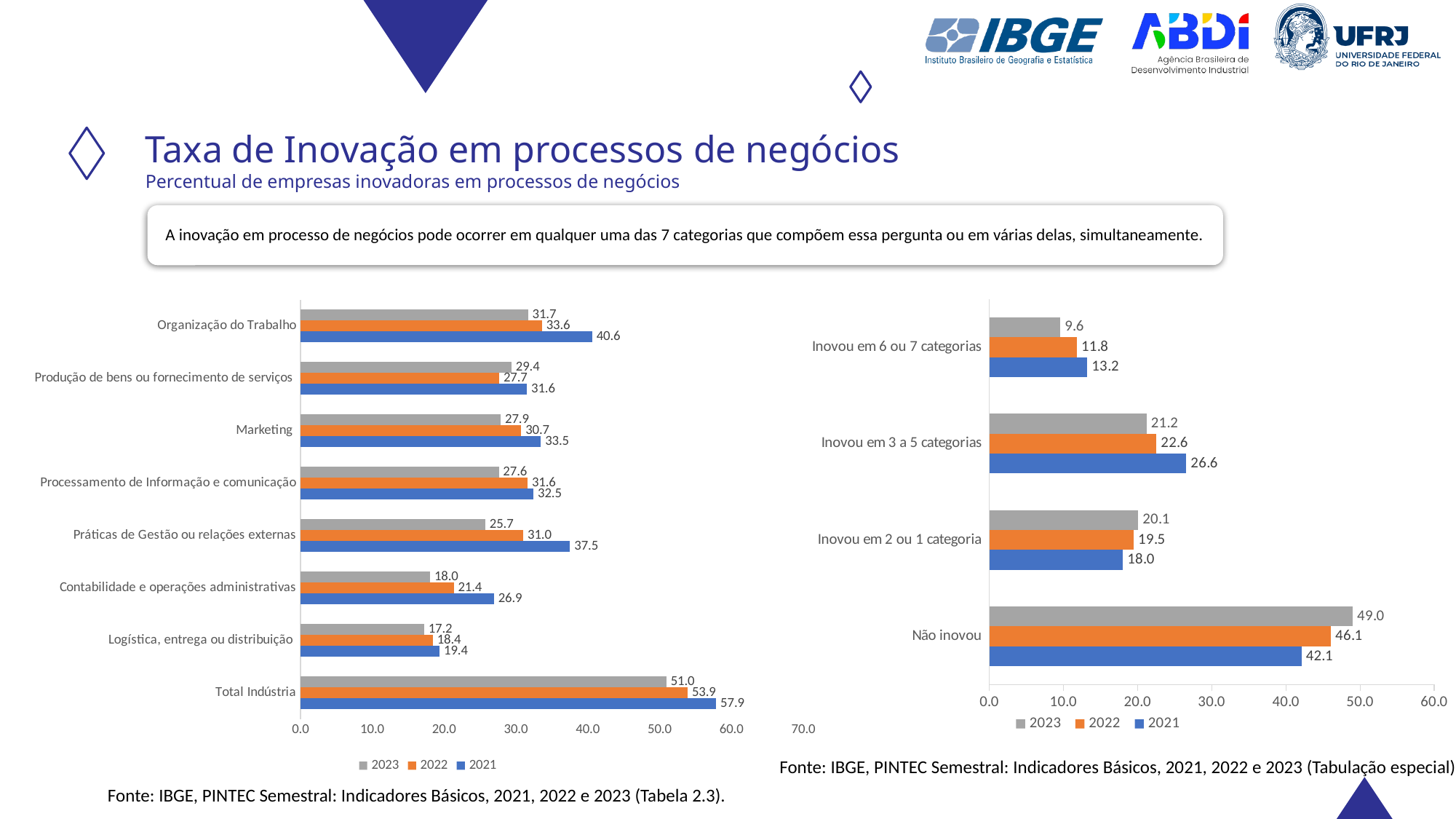
In the right chart, what is the 2022 value for Não inovou? 46.1 In the right chart, is the 2021 value for Inovou em 3 a 5 categorias larger or smaller than the 2023 value? larger In the right chart, how many categories are shown on the vertical axis? 4 In the left chart, which category has the lowest 2022 value? Logística, entrega ou distribuição In the right chart, what is the difference between the 2023 and 2021 values for Não inovou? 6.9 What type of chart is the left chart? Bar chart In the left chart, what is the difference between the 2021 and 2023 values for Práticas de Gestão ou relações externas? 11.8 In the left chart, how many series does the legend list? 3 In the left chart, what is the 2021 value for Organização do Trabalho? 40.6 In the right chart, which category has the lowest 2023 value? Inovou em 6 ou 7 categorias In the left chart, which category has the highest 2021 value? Total Indústria In the left chart, what is the 2023 value for Logística, entrega ou distribuição? 17.2